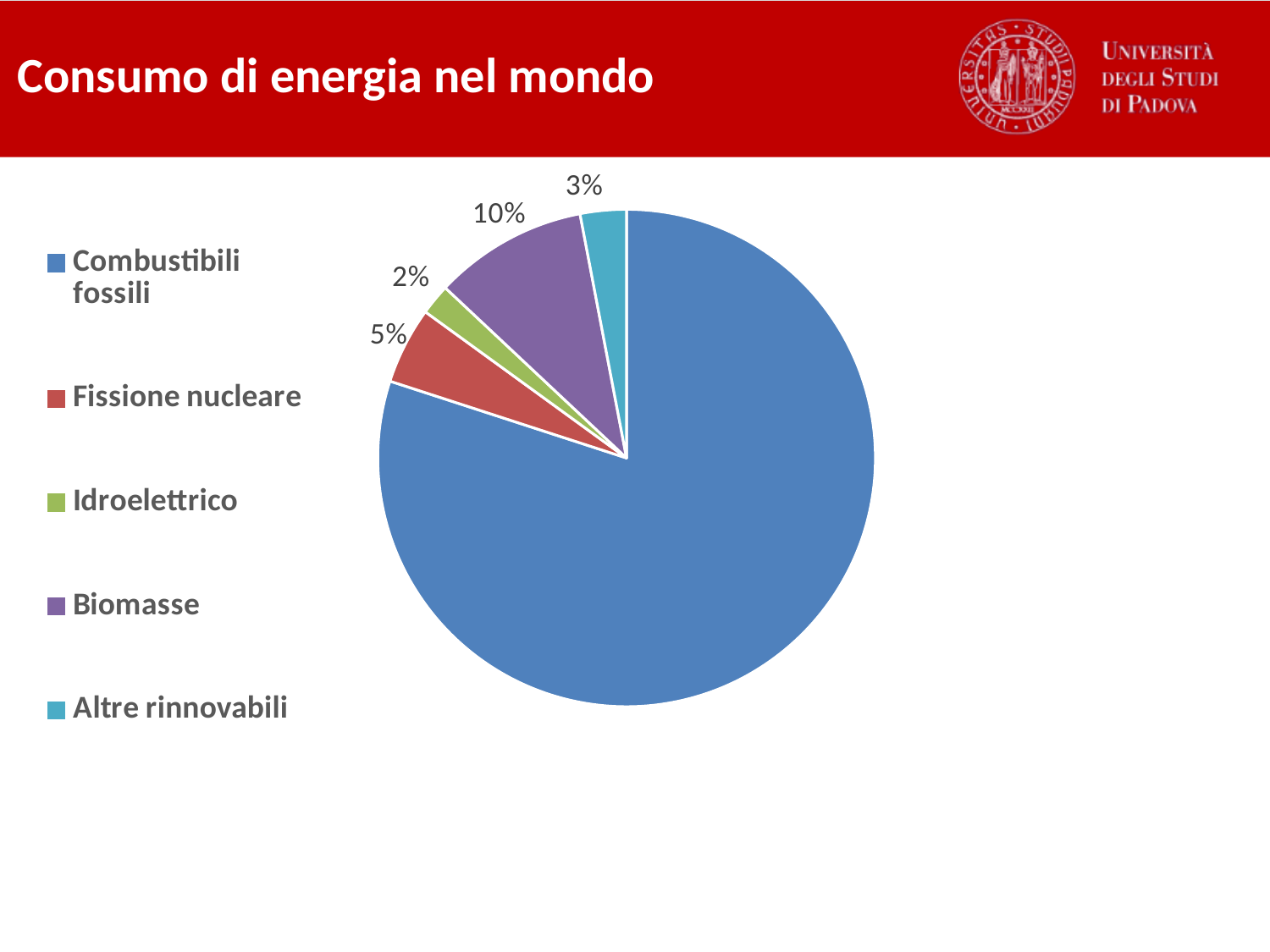
Which is larger, the slice for Altre rinnovabili or the slice for Fissione nucleare? Fissione nucleare How many percentage points larger is the Biomasse slice than the Fissione nucleare slice? 5 What colour is the slice for Biomasse? Purple What percentage is shown for Biomasse? 10% What share of the pie is labelled for Fissione nucleare? 5% What kind of chart is shown on the slide? Pie chart What percentage is shown for Idroelettrico? 2% What is the title of the slide containing the chart? Consumo di energia nel mondo What percentage is shown for Altre rinnovabili? 3% Which category has the smallest slice of the pie? Idroelettrico Which category has the largest slice of the pie? Combustibili fossili How many categories does the pie chart show? 5